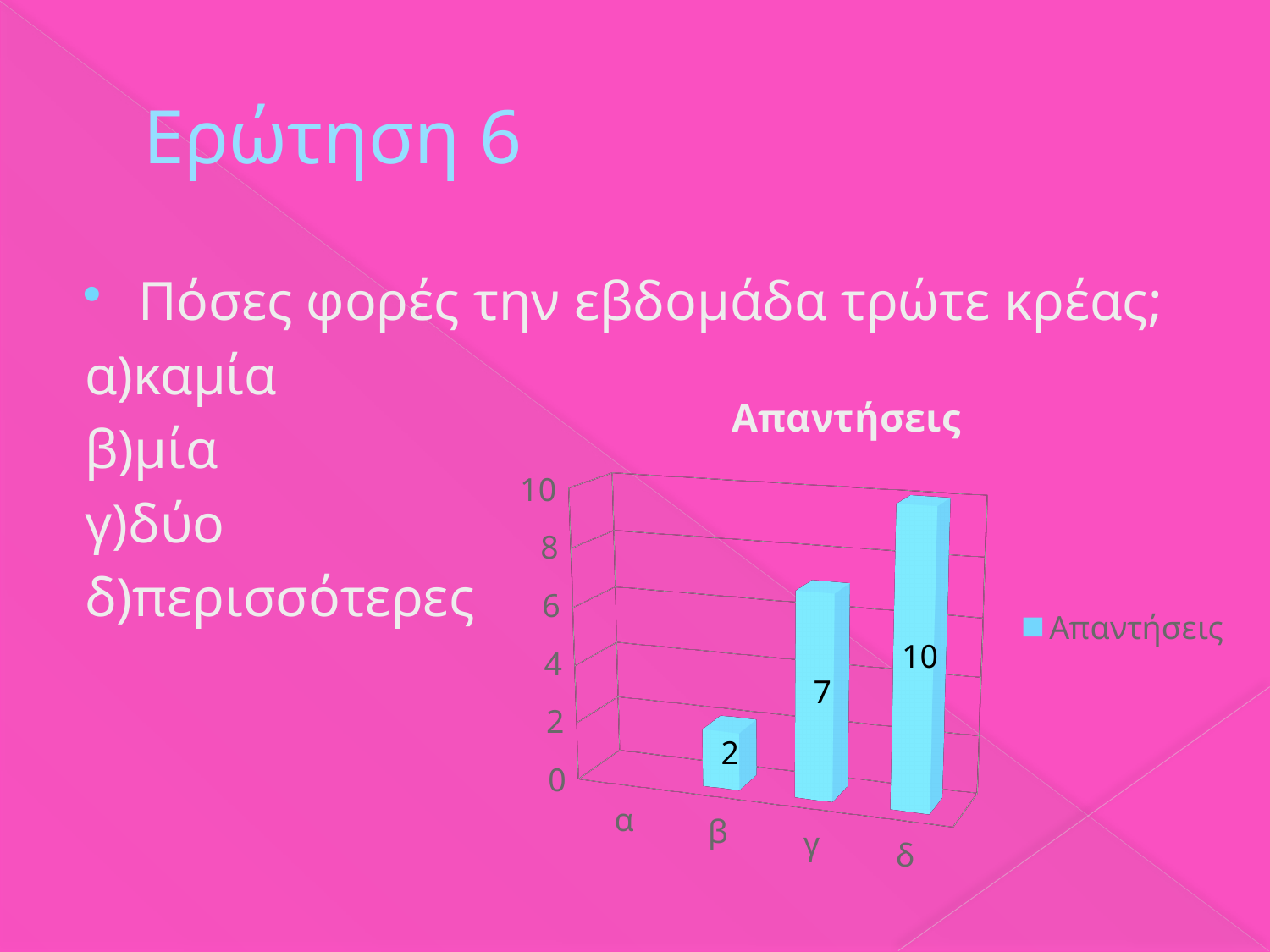
What is the value for category δ in the Απαντήσεις chart? 10 How many categories are shown on the x axis of the Απαντήσεις chart? 4 How many series does the legend of the Απαντήσεις chart list? 1 What kind of chart is shown on the slide? bar chart What is the value for category β in the Απαντήσεις chart? 2 Which category has the highest value in the Απαντήσεις chart? δ What is the title of the chart on the slide? Απαντήσεις What is the value for category γ in the Απαντήσεις chart? 7 Which is larger in the Απαντήσεις chart, the value for β or the value for γ? γ What is the difference between the values for γ and β in the Απαντήσεις chart? 5 What is the difference between the values for δ and γ in the Απαντήσεις chart? 3